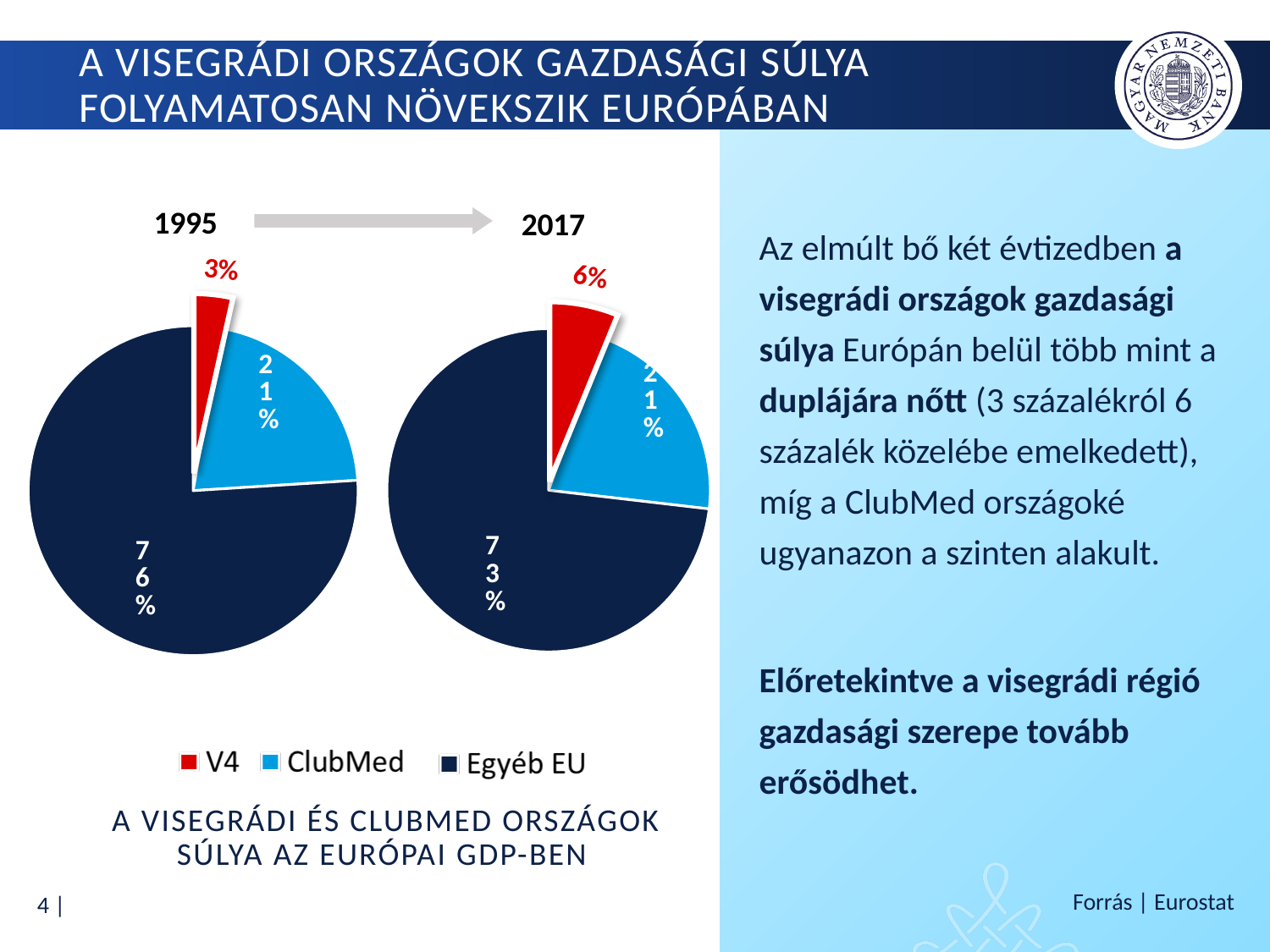
In the 2017 pie chart, what share does V4 have? 6% In the 1995 pie chart, which category has the largest slice? Egyéb EU By how many percentage points did the V4 share increase from the 1995 pie chart to the 2017 pie chart? 3 percentage points Is the V4 share larger in the 1995 pie chart or in the 2017 pie chart? 2017 In the 2017 pie chart, what is the difference between the Egyéb EU share and the ClubMed share? 52 percentage points How many series does the legend list for the pie charts? 3 What type of chart is used to show the 1995 and 2017 data? Pie chart In the 2017 pie chart, what share does ClubMed have? 21% In the 1995 pie chart, what share does Egyéb EU have? 76% In the 1995 pie chart, what share does V4 have? 3% In the 2017 pie chart, which category has the smallest slice? V4 In the 2017 pie chart, what share does Egyéb EU have? 73%